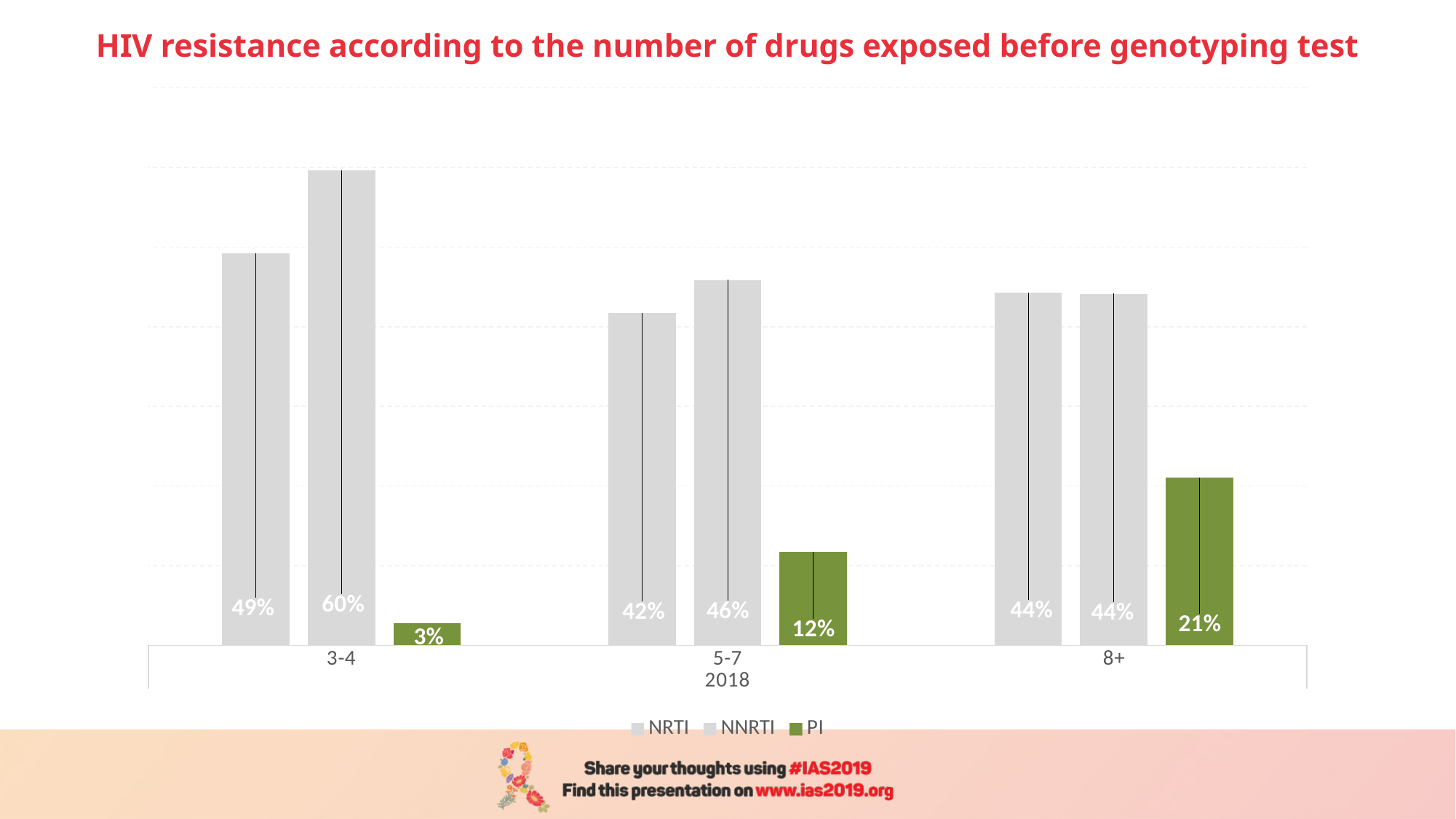
How many series does the legend list? 3 What is the difference between NNRTI and NRTI resistance in the 3-4 drugs group? 11% Does PI resistance rise or fall as the number of drugs exposed increases? Rise What is the NRTI resistance value for the 5-7 drugs group? 42% What kind of chart is shown on the slide? Bar chart What is the PI resistance value for the 8+ drugs group? 21% What is the NNRTI resistance value for the 3-4 drugs group? 60% What is the difference in PI resistance between the 8+ group and the 5-7 group? 9% Which is larger, NNRTI resistance in the 3-4 group or NNRTI resistance in the 5-7 group? 3-4 group Which drug-exposure group has the highest PI resistance? 8+ Which drug-exposure group has the lowest PI resistance? 3-4 How many drug-exposure groups are shown on the x axis? 3